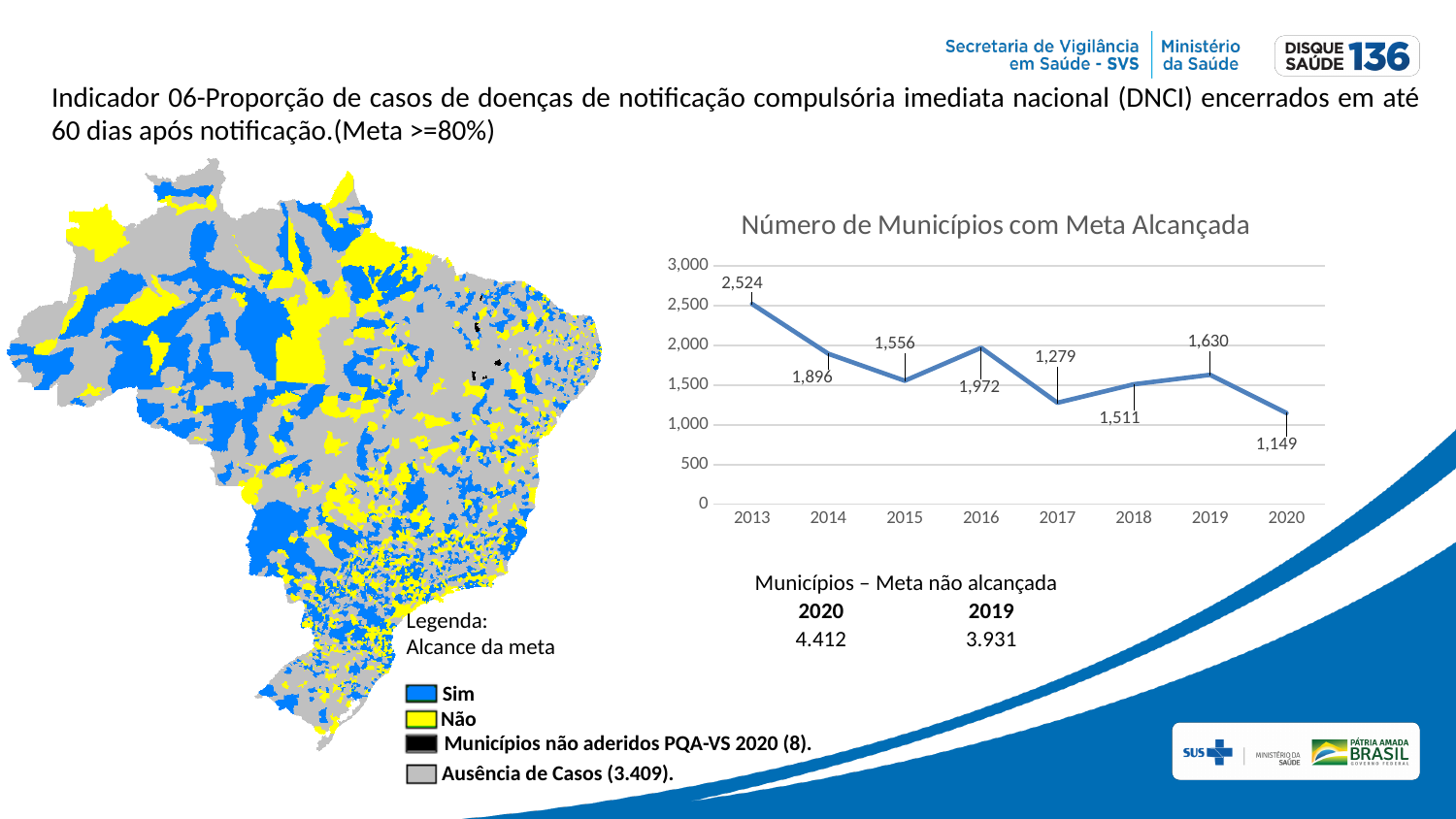
In the chart 'Número de Municípios com Meta Alcançada', what is the value for 2013? 2,524 In the chart 'Número de Municípios com Meta Alcançada', is the value for 2014 greater or less than 1,500? greater In the chart 'Número de Municípios com Meta Alcançada', which year has a larger value, 2017 or 2018? 2018 In the chart 'Número de Municípios com Meta Alcançada', what is the difference between the values for 2019 and 2020? 481 How many years are plotted on the x axis of the chart 'Número de Municípios com Meta Alcançada'? 8 In the chart 'Número de Municípios com Meta Alcançada', what is the value for 2016? 1,972 In the chart 'Número de Municípios com Meta Alcançada', what is the value for 2020? 1,149 In the chart 'Número de Municípios com Meta Alcançada', which year has the highest value? 2013 In the chart 'Número de Municípios com Meta Alcançada', which year has the lowest value? 2020 What type of chart is used to show the number of municipalities that reached the target? line chart In the chart 'Número de Municípios com Meta Alcançada', does the value rise or fall from 2013 to 2014? fall What is the title of the line chart on the slide? Número de Municípios com Meta Alcançada